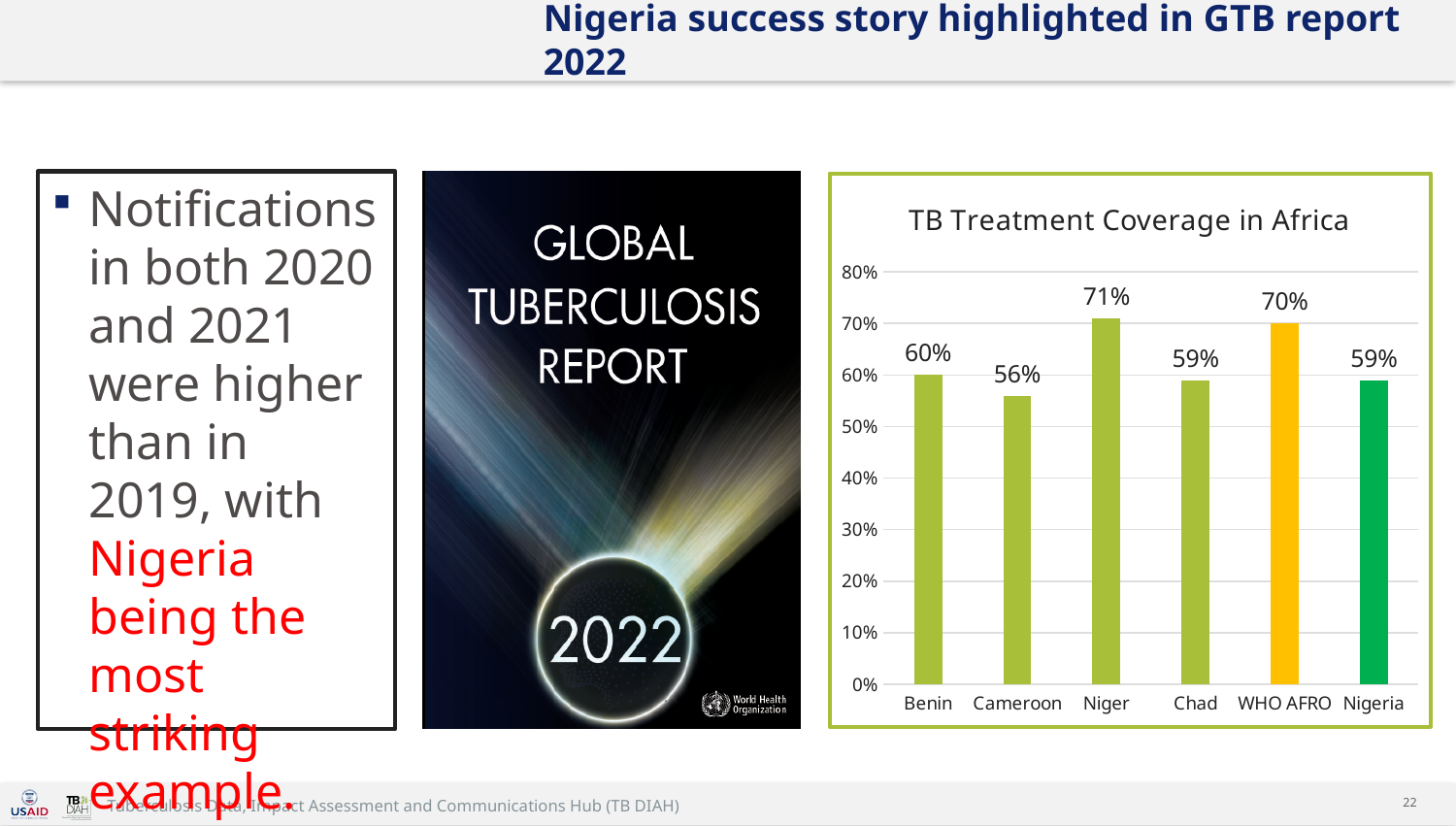
Which category has the highest TB treatment coverage? Niger Which has a higher TB treatment coverage, Benin or Cameroon? Benin What kind of chart is shown on the slide? Bar chart What colour is the bar for WHO AFRO? Yellow What is the title of the chart? TB Treatment Coverage in Africa What is the TB treatment coverage value for Niger? 71% What is the TB treatment coverage value for WHO AFRO? 70% What is the difference between the TB treatment coverage for Niger and Cameroon? 15% Which category has the lowest TB treatment coverage? Cameroon How many categories are shown on the x axis of the chart? 6 What is the TB treatment coverage value for Cameroon? 56% Is the value for Chad greater or less than 50%? greater